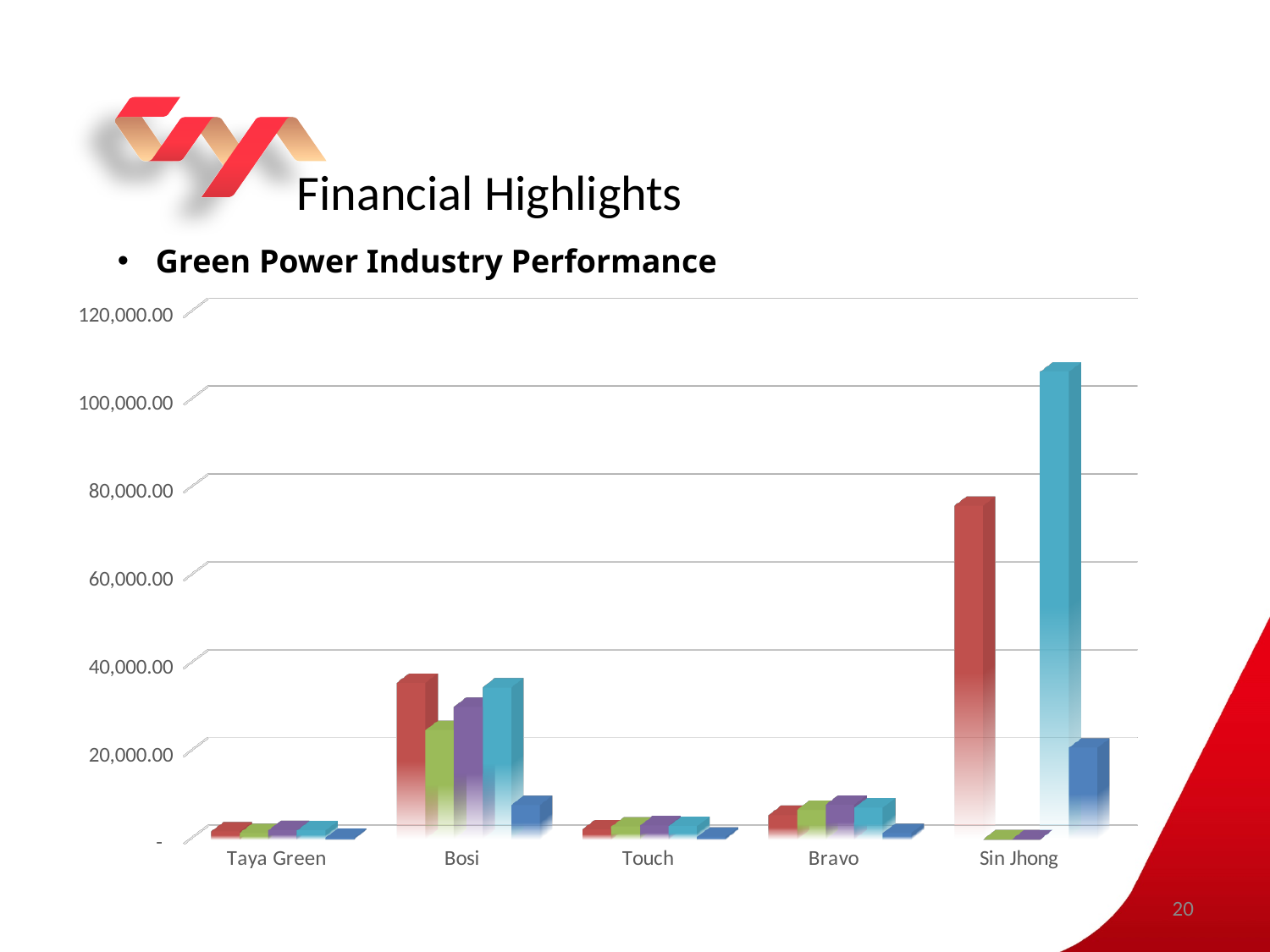
Is the value of the red bar for Sin Jhong greater or less than 60,000.00? greater How many categories are shown on the x axis of the chart? 5 Which category has the tallest bar in the chart? Sin Jhong What is the highest value labelled on the vertical axis of the chart? 120,000.00 What kind of chart is shown on the slide? Bar chart Is the value of the tallest (cyan) bar for Sin Jhong greater or less than 100,000.00? greater For Sin Jhong, which is larger, the red bar or the cyan bar? The cyan bar Is the value of the red bar for Sin Jhong greater or less than 80,000.00? less Which is larger, the red bar for Bosi or the red bar for Bravo? Bosi